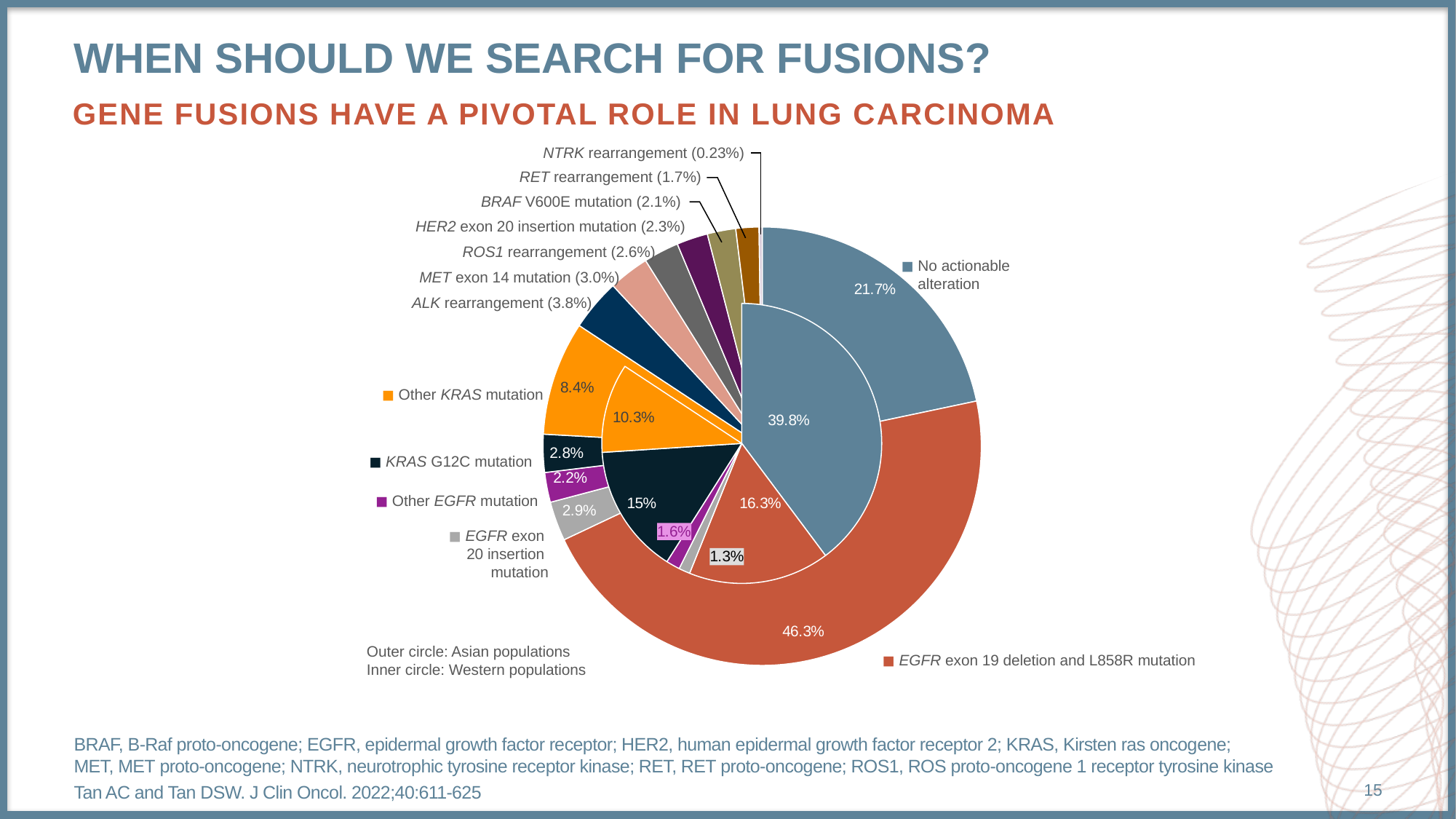
What percentage of the outer circle (Asian populations) is EGFR exon 19 deletion and L858R mutation? 46.3% What is the difference between the No actionable alteration share in the inner circle (39.8%) and the outer circle (21.7%)? 18.1% What percentage is shown for NTRK rearrangement? 0.23% What percentage is shown for MET exon 14 mutation? 3.0% Which category has the largest share in the inner circle (Western populations)? No actionable alteration Which population does the outer circle represent? Asian populations What percentage is shown for ALK rearrangement in the outer circle? 3.8% What percentage of the inner circle (Western populations) is KRAS G12C mutation? 15% What type of chart is shown on the slide? Pie chart What percentage of the inner circle (Western populations) is No actionable alteration? 39.8% Which is larger in the outer circle: Other KRAS mutation or KRAS G12C mutation? Other KRAS mutation Which category has the largest share in the outer circle (Asian populations)? EGFR exon 19 deletion and L858R mutation